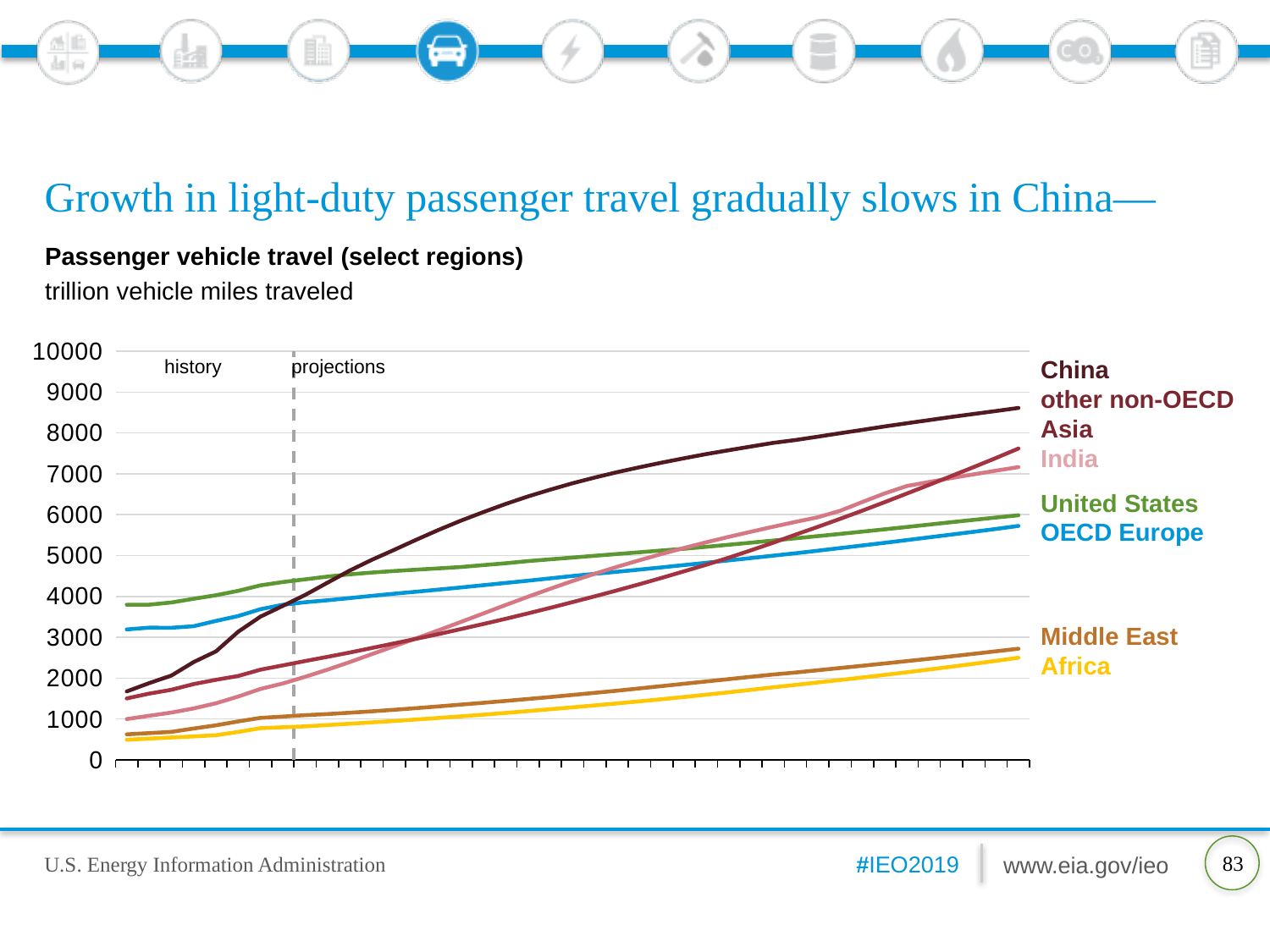
Does the value for India rise or fall over the projection period? rise Which is larger throughout the chart: the value for Middle East or the value for Africa? Middle East Is the value for OECD Europe at the end of the projection period greater or less than 6000? less What kind of chart is shown on the slide? line chart Which region has the lowest passenger vehicle travel at the end of the projection period? Africa Is the value for Africa at the end of the projection period greater or less than 2000? greater What unit is the chart measured in, according to the subtitle? trillion vehicle miles traveled Is the value for Middle East at the end of the projection period greater or less than 3000? less At the end of the projection period, which is larger: the value for China or the value for the United States? China Which region has the highest passenger vehicle travel at the end of the projection period? China How many series (regions) are plotted on the chart? 7